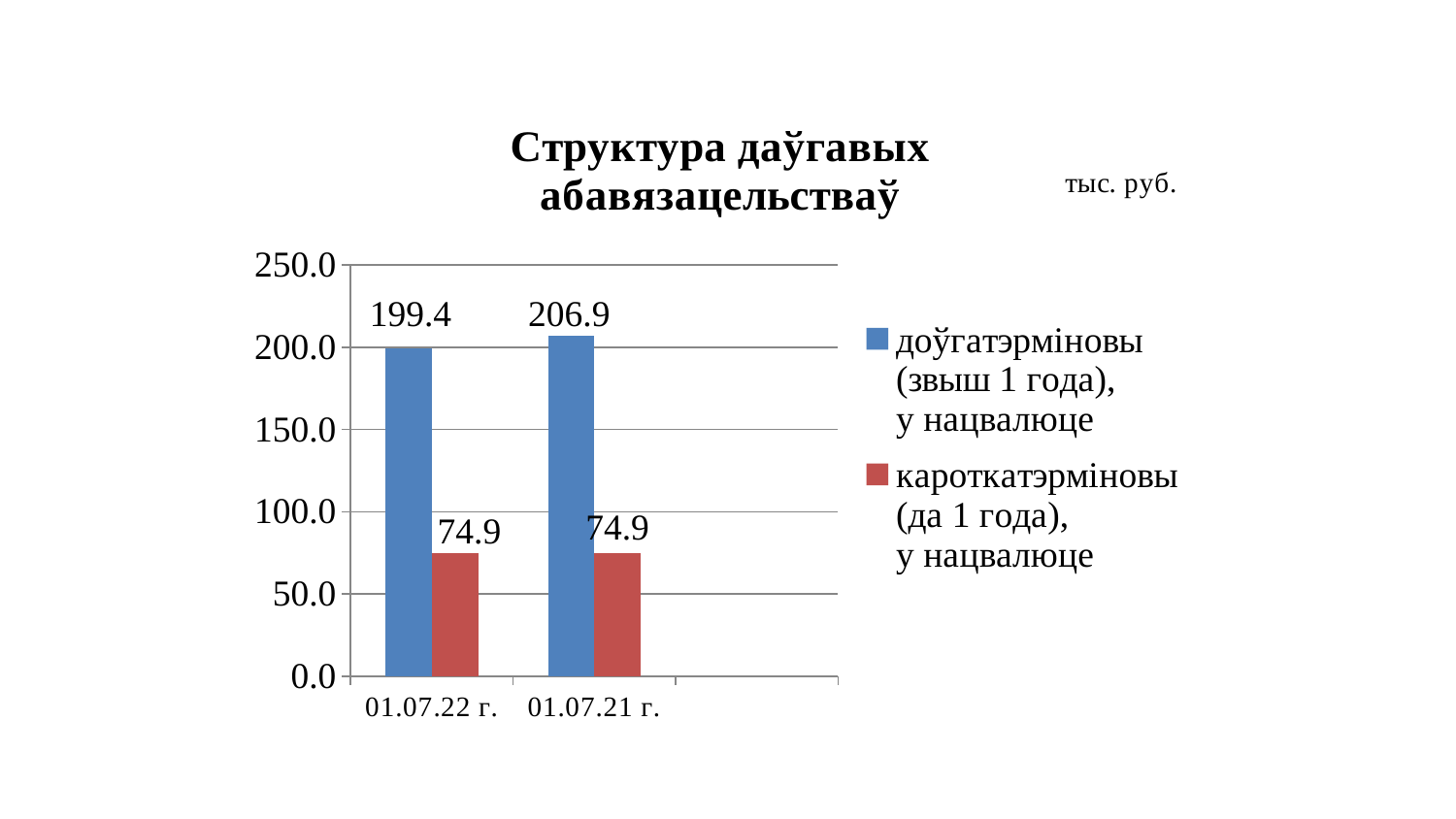
What is the value of the long-term (доўгатэрміновы) series for 01.07.21 г.? 206.9 What is the value of the short-term (кароткатэрміновы) series for 01.07.22 г.? 74.9 Is the short-term value for 01.07.22 г. greater or less than 100.0? less What is the value of the long-term (доўгатэрміновы) series for 01.07.22 г.? 199.4 Which date has the higher value for the long-term (доўгатэрміновы) series? 01.07.21 г. What kind of chart is shown on the slide? bar chart What is the value of the short-term (кароткатэрміновы) series for 01.07.21 г.? 74.9 What is the difference between the long-term and short-term values for 01.07.22 г.? 124.5 For 01.07.21 г., which is larger: the long-term or the short-term value? long-term (доўгатэрміновы) How many series does the legend list? 2 What is the difference between the long-term values for 01.07.21 г. and 01.07.22 г.? 7.5 How many categories (dates) are shown on the x axis? 2